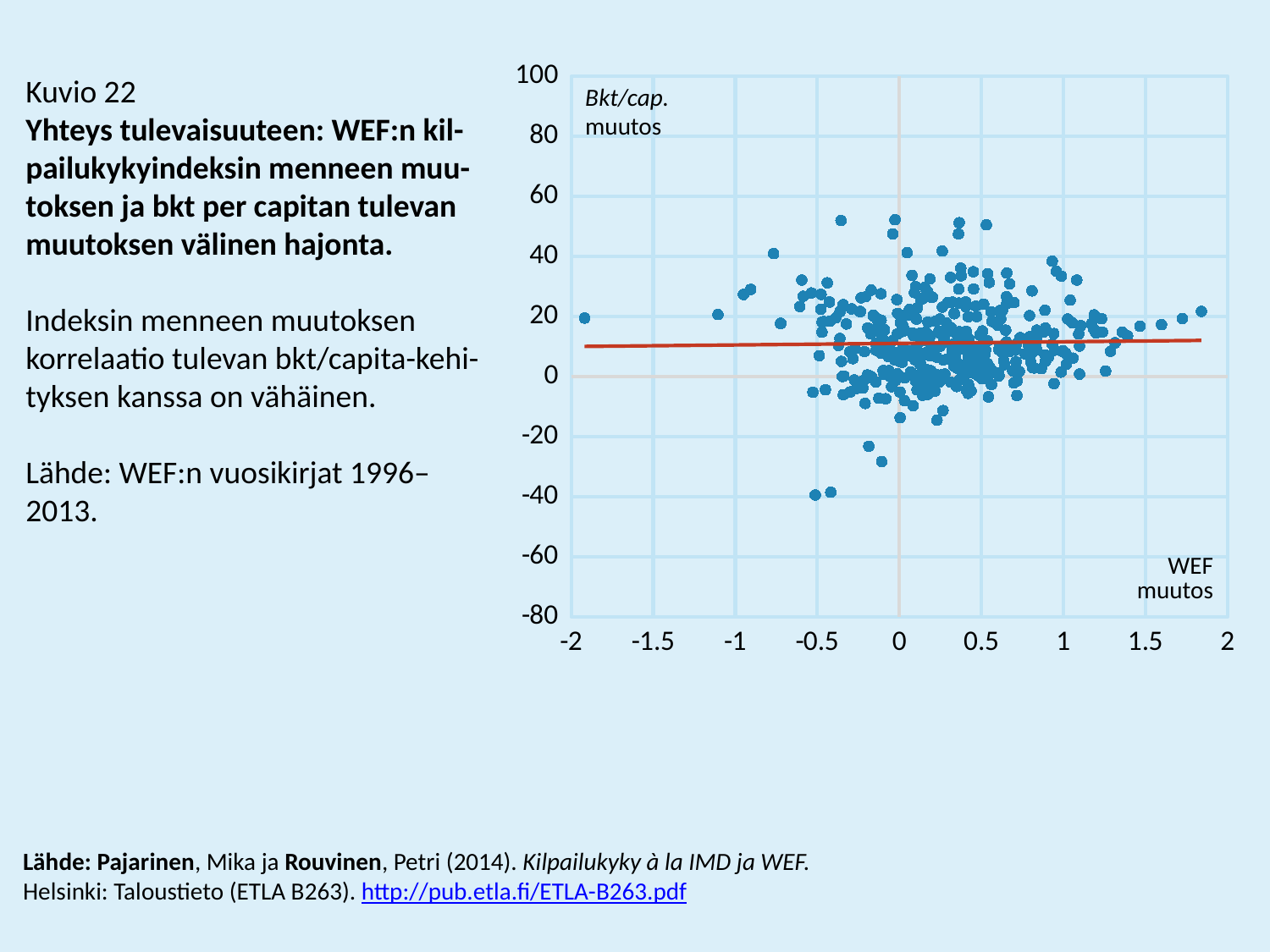
Does the red fitted line rise or fall from left to right along the WEF muutos axis? rises slightly (nearly flat) Is the value of the red fitted line at WEF muutos 0 greater or less than 20? less What is the label of the vertical axis of the chart? Bkt/cap. muutos Is the value of the red fitted line at WEF muutos 0 greater or less than 0? greater Is the Bkt/cap. muutos value of the highest point in the chart greater or less than 40? greater What is the label of the horizontal axis of the chart? WEF muutos What kind of chart is shown on the slide? scatter chart Are there more points with positive WEF muutos or with negative WEF muutos? positive WEF muutos Are there more points above 0 or below 0 on the Bkt/cap. muutos axis? above 0